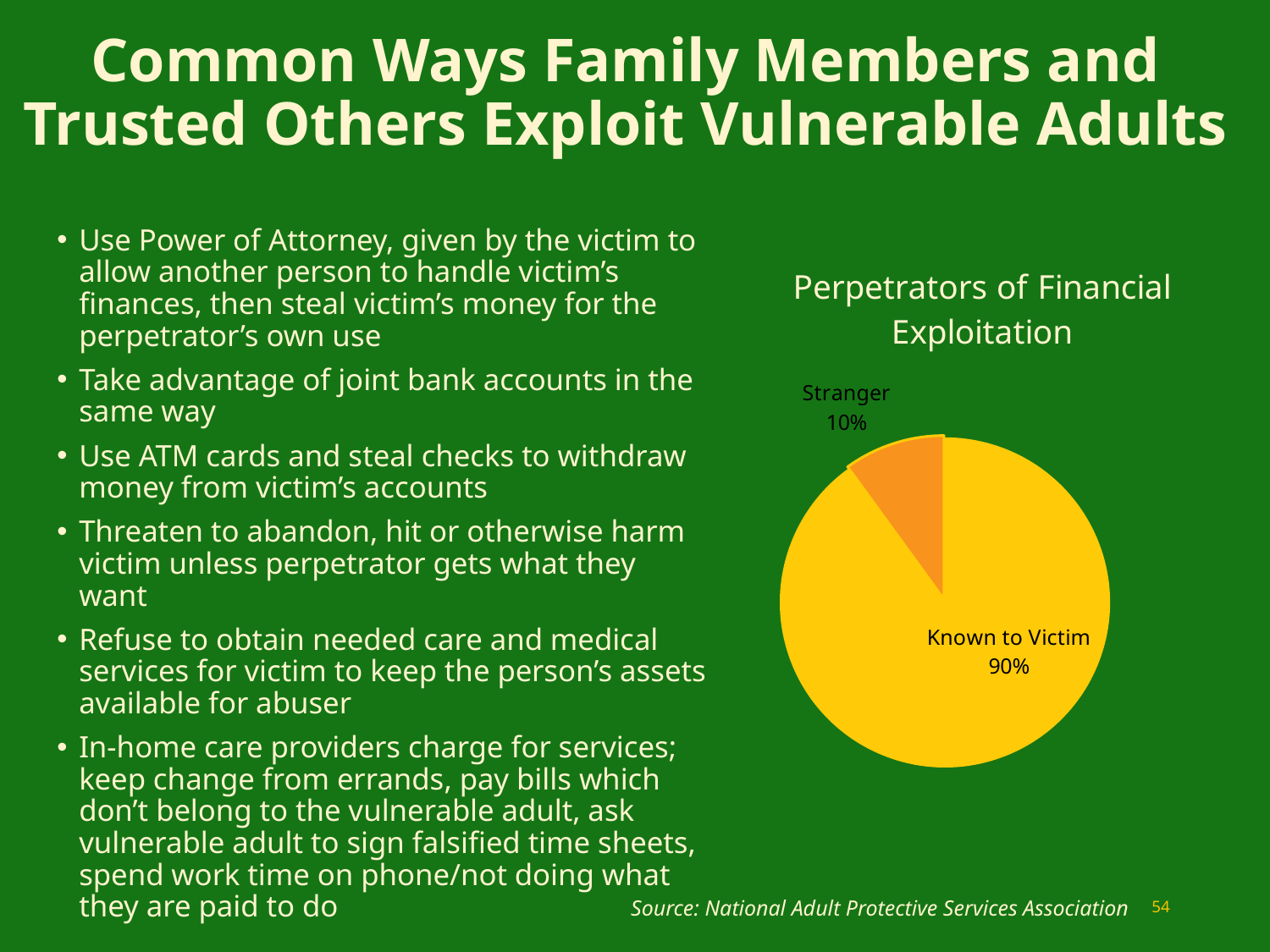
What is the difference in percentage points between the Known to Victim and Stranger slices? 80 Which category has the smallest share of the pie? Stranger Which category has the largest share of the pie? Known to Victim What is the title of the chart? Perpetrators of Financial Exploitation Which is larger, the Stranger slice or the Known to Victim slice? Known to Victim What share of perpetrators of financial exploitation are Known to Victim? 90% What type of chart is shown on the slide? pie chart How many slices does the pie chart have? 2 What share of perpetrators of financial exploitation are Strangers? 10% What is the source cited for the chart data? National Adult Protective Services Association